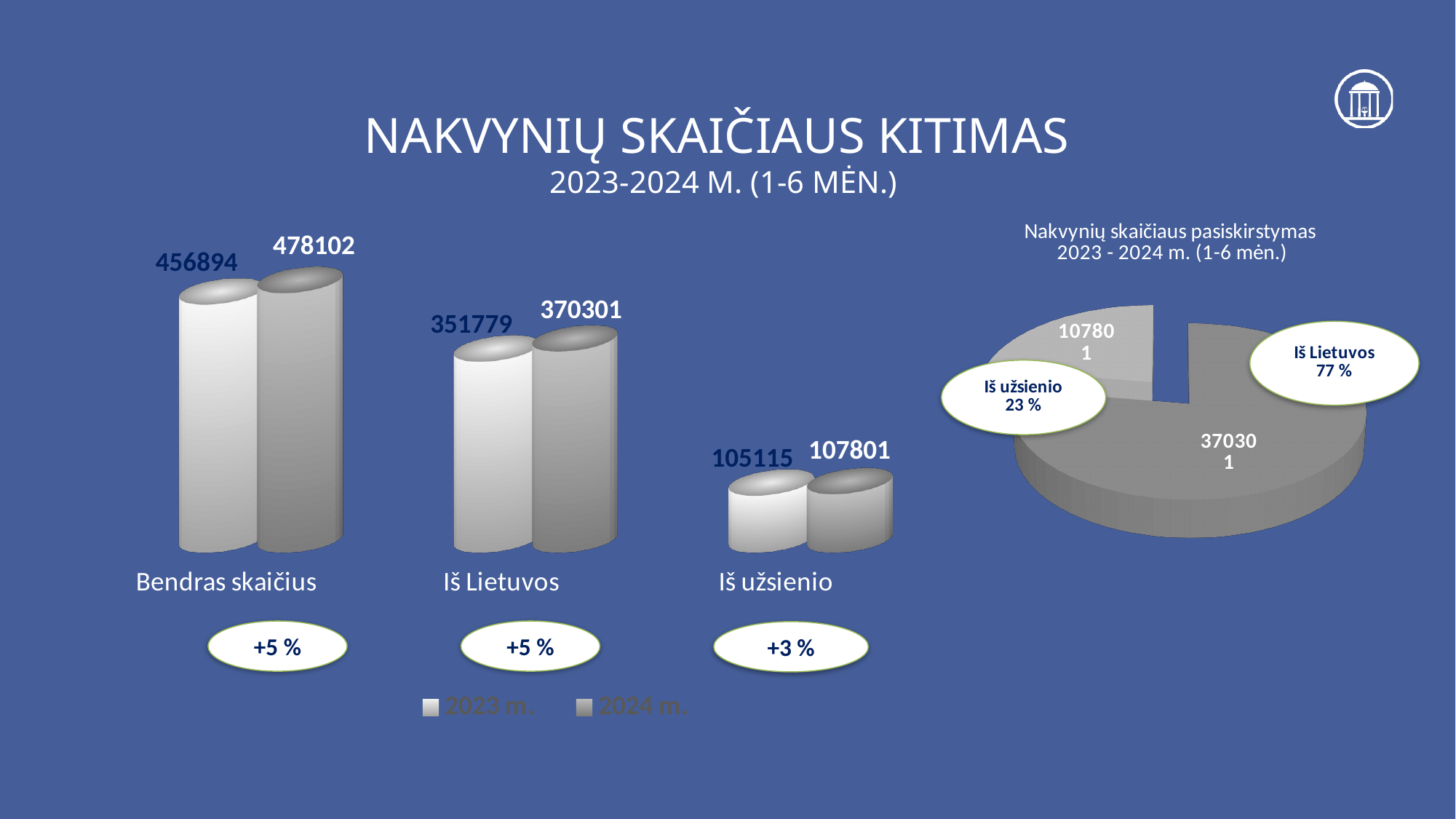
How many series does the legend of the bar chart on the left list? 2 What type of chart is the chart on the right titled 'Nakvynių skaičiaus pasiskirstymas'? Pie chart In the bar chart on the left, what is the value for Iš Lietuvos in 2023 m.? 351779 In the bar chart on the left, what is the value for Bendras skaičius in 2024 m.? 478102 In the pie chart on the right, what share of the total is Iš Lietuvos? 77 % In the bar chart on the left, which category has the highest values? Bendras skaičius In the bar chart on the left, what is the value for Iš užsienio in 2024 m.? 107801 In the bar chart on the left, what is the difference between the 2024 m. and 2023 m. values for Iš užsienio? 2686 In the bar chart on the left, what is the difference between the 2024 m. and 2023 m. values for Bendras skaičius? 21208 In the bar chart on the left, which is larger for Iš Lietuvos: the 2023 m. value or the 2024 m. value? 2024 m. In the bar chart on the left, which category has the lowest values? Iš užsienio How many categories are shown in the bar chart on the left? 3